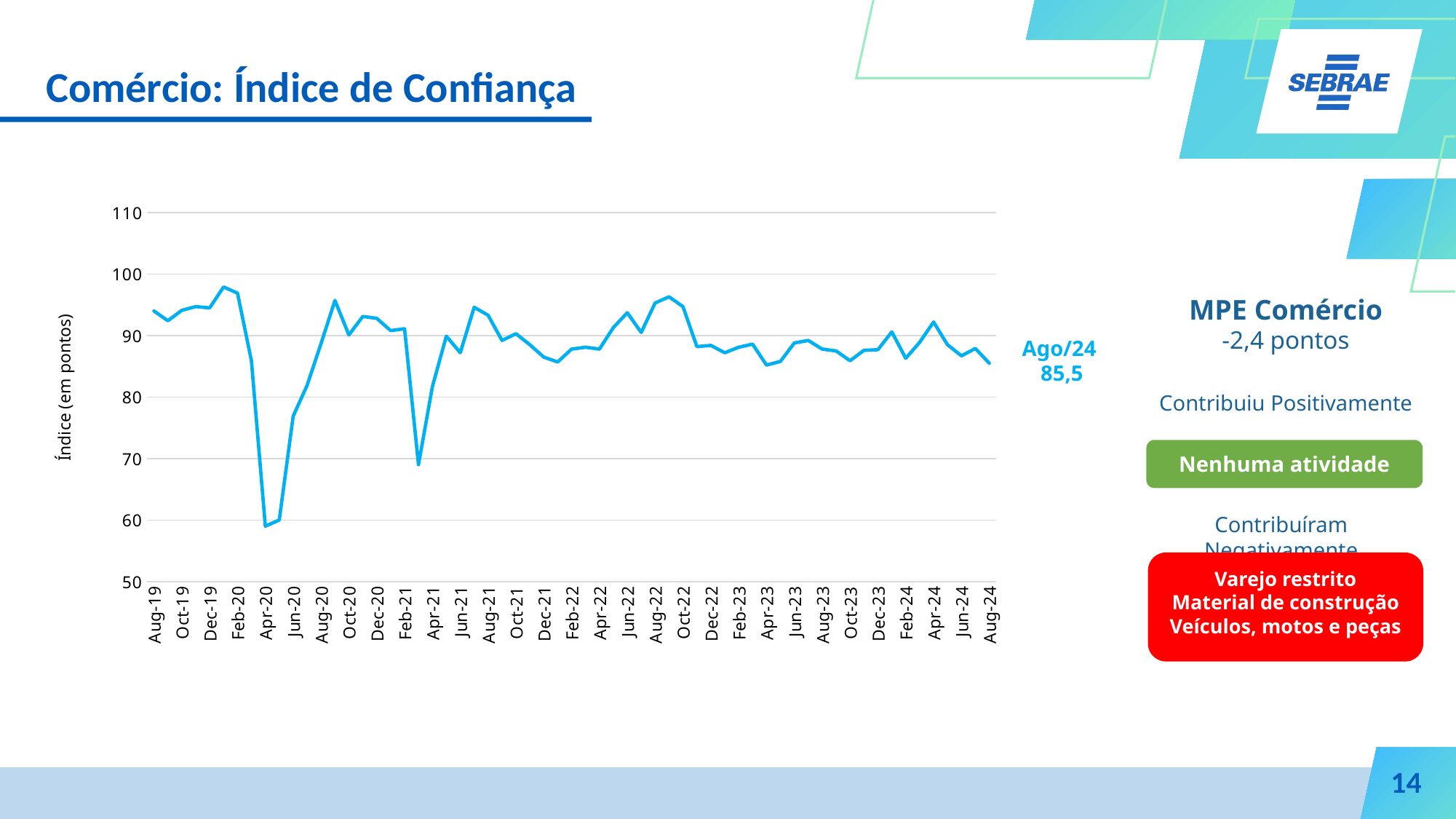
Is the value for Aug-22 greater or less than 90? greater Which is larger, the value for Apr-20 or the value for Feb-21? Feb-21 What kind of chart is shown on the slide? line chart How many lines (series) are plotted on the chart? 1 What is the label of the vertical axis? Índice (em pontos) Does the index rise or fall between Apr-24 and Aug-24? fall Is the value for Aug-24 greater or less than 90? less Which is larger, the value for Aug-19 or the value for Aug-24? Aug-19 At which labelled month does the index reach its lowest point? Apr-20 Is the value for Apr-20 greater or less than 70? less What is the value of the index for Aug-24 (Ago/24) according to the data label? 85,5